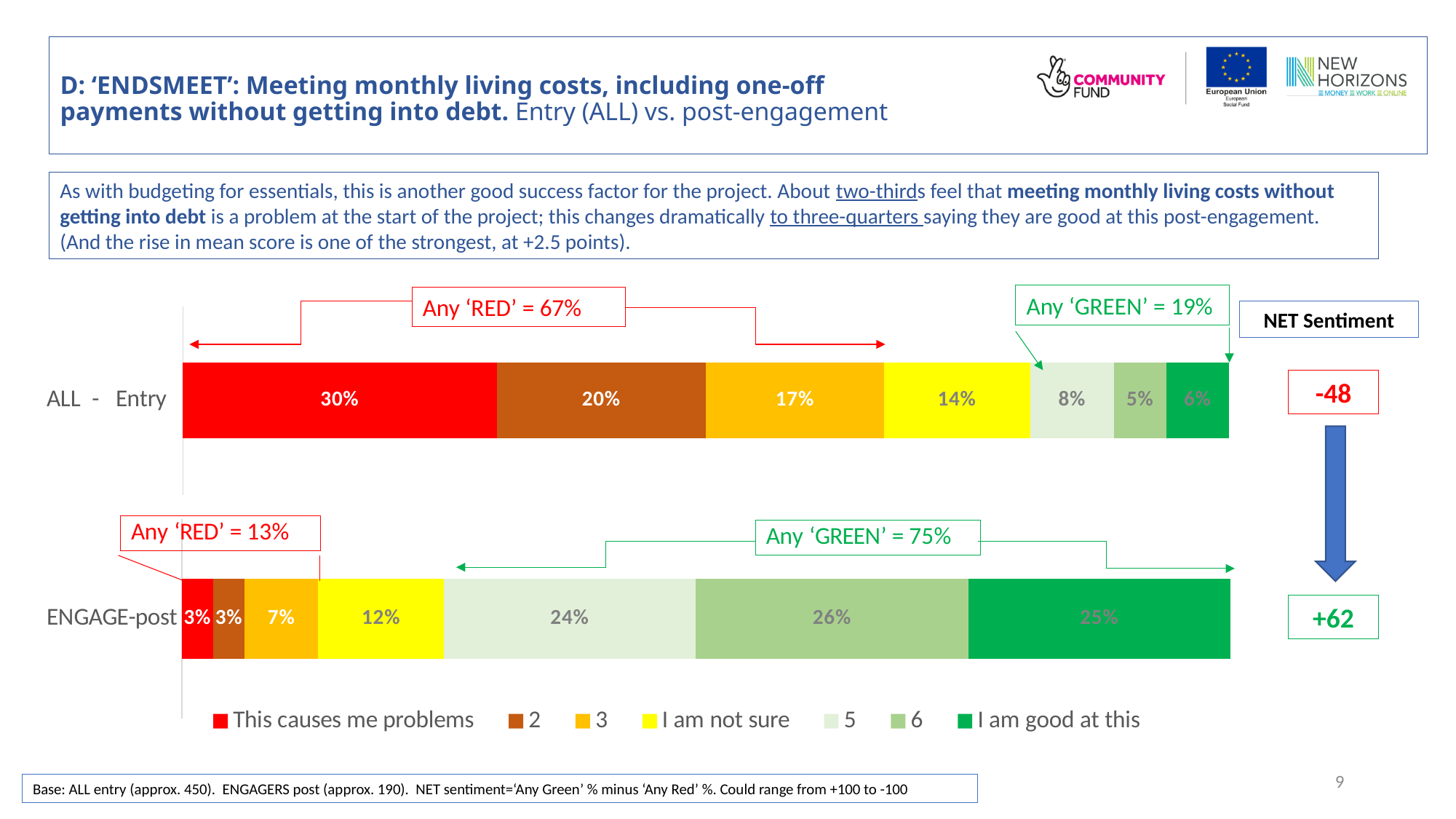
What percentage of the 'ENGAGE-post' bar is 'I am good at this'? 25% What is the NET Sentiment shown for 'ENGAGE-post'? +62 What is the difference between the 'This causes me problems' values for 'ALL - Entry' and 'ENGAGE-post'? 27% What percentage of the 'ALL - Entry' bar is 'This causes me problems'? 30% What kind of chart is shown on the slide? Stacked bar chart Which segment is the smallest in the 'ALL - Entry' bar? 6 What is the value for 'I am not sure' in the 'ENGAGE-post' bar? 12% How many series does the legend list? 7 Which segment is the largest in the 'ENGAGE-post' bar? 6 How many bars are plotted in the chart? 2 Which bar has the larger value for series '5', 'ALL - Entry' or 'ENGAGE-post'? ENGAGE-post What is the value for series '6' in the 'ALL - Entry' bar? 5%